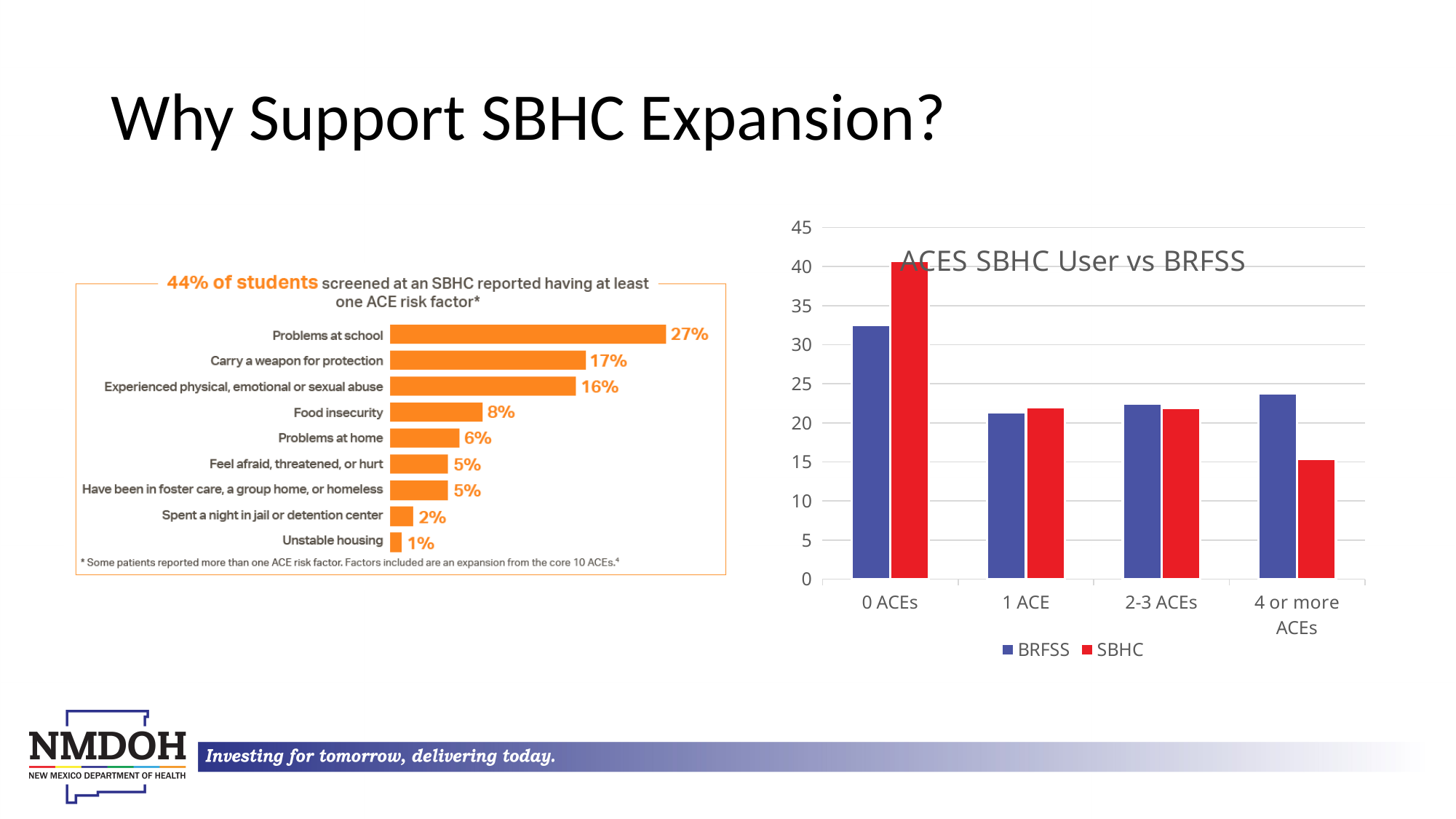
In the left chart on ACE risk factors, which risk factor has the highest percentage? Problems at school In the left chart on ACE risk factors, what is the difference between the percentages for 'Carry a weapon for protection' and 'Experienced physical, emotional or sexual abuse'? 1% In the chart 'ACES SBHC User vs BRFSS', for which category is the SBHC value highest? 0 ACEs In the chart 'ACES SBHC User vs BRFSS', is the SBHC value for 4 or more ACEs greater or less than 20? less In the left chart on ACE risk factors, what percentage of students reported food insecurity? 8% In the chart 'ACES SBHC User vs BRFSS', which series has the larger value for 4 or more ACEs, BRFSS or SBHC? BRFSS What type of chart is 'ACES SBHC User vs BRFSS'? Bar chart In the left chart on ACE risk factors, which risk factor has the lowest percentage? Unstable housing In the left chart on ACE risk factors, what percentage of students reported problems at school? 27% In the left chart on ACE risk factors, how many risk factors are listed? 9 In the chart 'ACES SBHC User vs BRFSS', is the SBHC value for 0 ACEs greater or less than 35? greater In the chart 'ACES SBHC User vs BRFSS', how many series does the legend list? 2